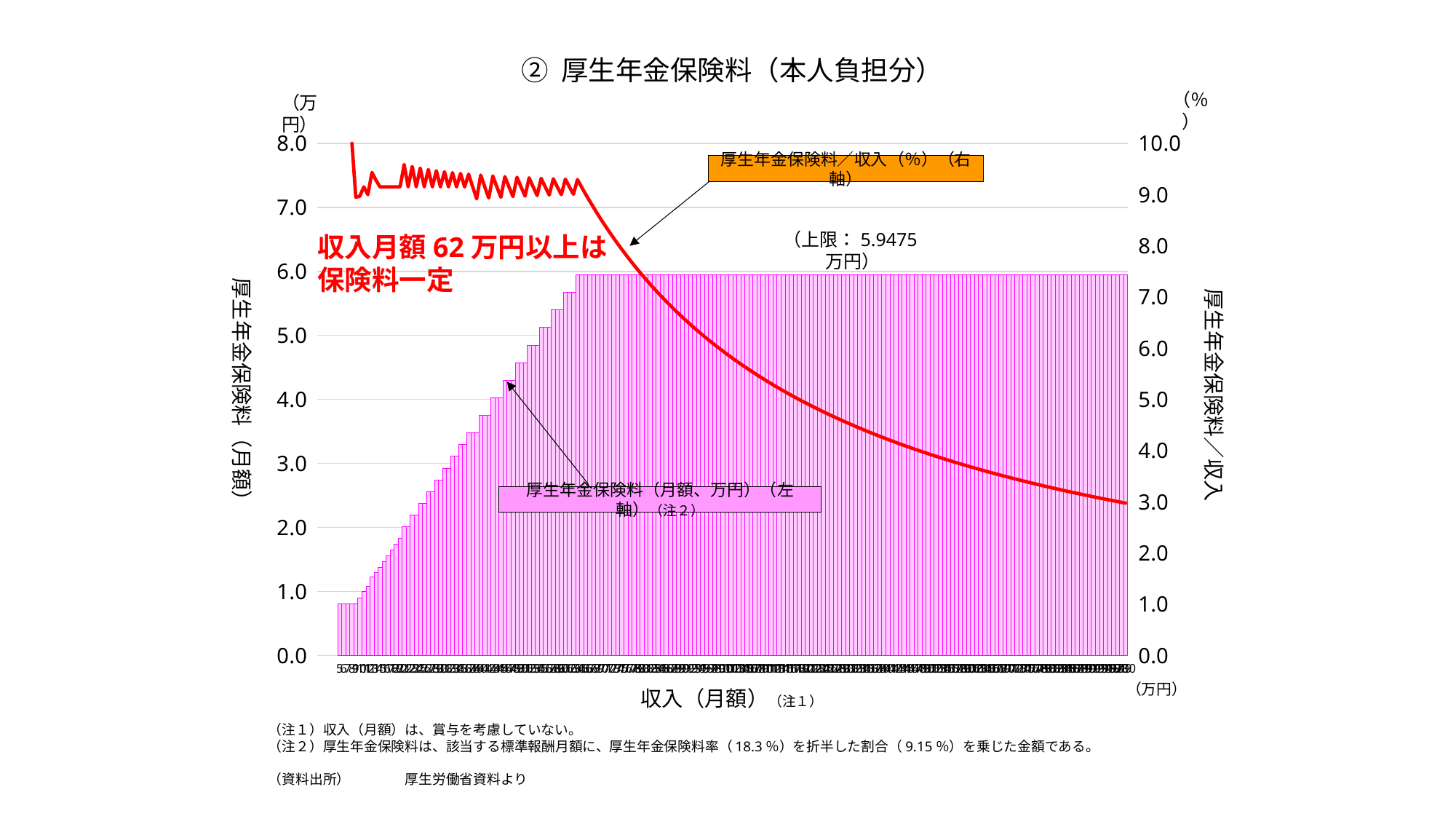
What is the upper limit (上限) of the monthly 厚生年金保険料 shown on the chart? 5.9475万円 What is the title of the chart? ② 厚生年金保険料（本人負担分） What is the maximum value shown on the right vertical axis? 10.0 Is the highest value of the red line (厚生年金保険料／収入) greater or less than 9.0%? greater At the right end of the chart, is the value of the red line (厚生年金保険料／収入) greater or less than 4.0%? less What kind of chart is this? Combination bar and line chart Are the tallest pink bars (厚生年金保険料 monthly amount) greater or less than 7.0万円? less According to the red annotation, from what monthly income onward is the premium constant? 62万円以上 What is the maximum value shown on the left vertical axis? 8.0 How many data series are plotted on the chart? 2 Do the pink bars (厚生年金保険料 monthly amount) rise or fall as income increases before reaching the upper limit? Rise Does the red line (厚生年金保険料／収入) rise or fall overall as income increases along the x axis? Falls